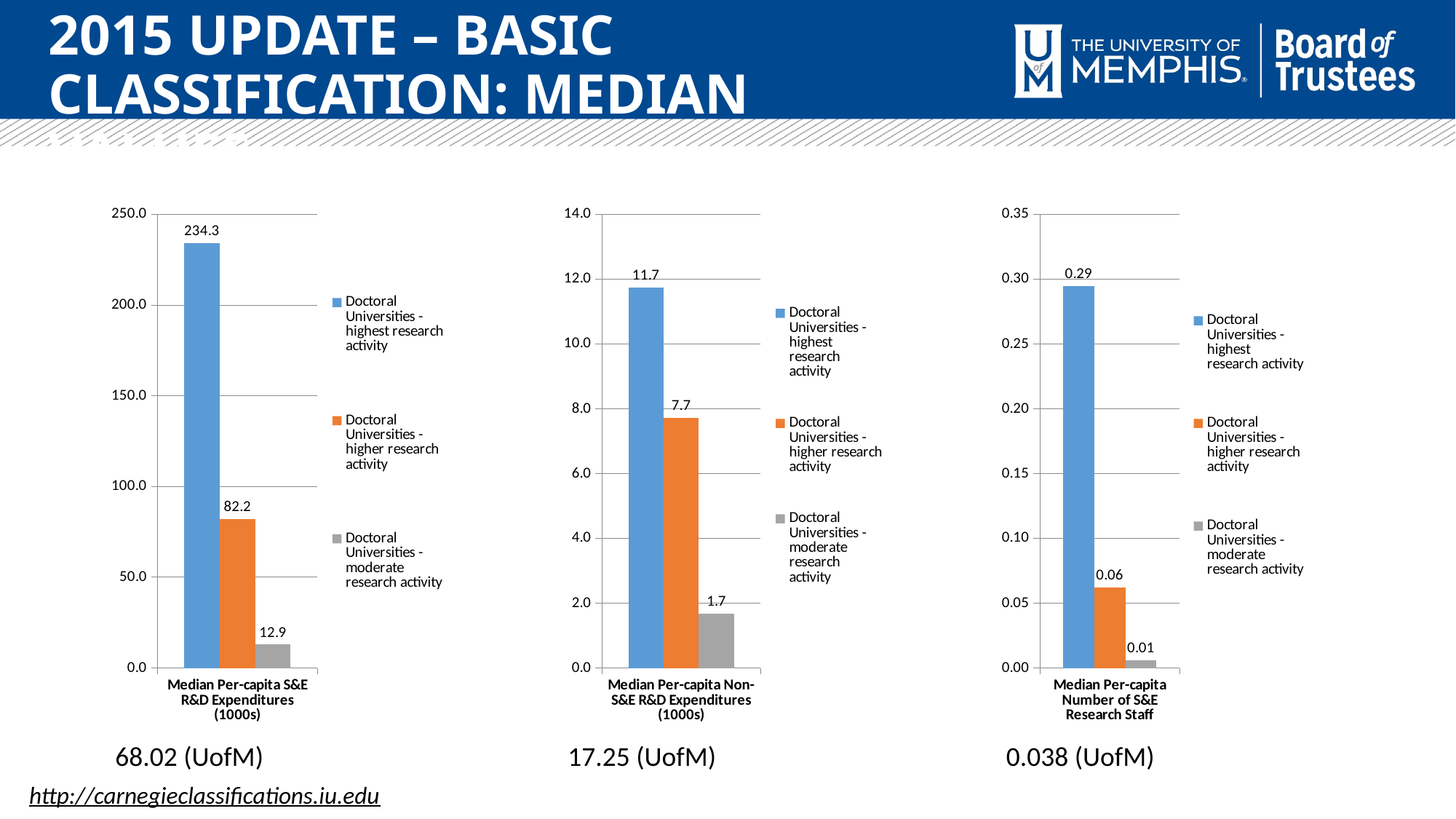
How many series does the legend of the middle chart (Median Per-capita Non-S&E R&D Expenditures) list? 3 In the left chart (Median Per-capita S&E R&D Expenditures), what is the difference between the highest research activity value and the higher research activity value? 152.1 In the right chart (Median Per-capita Number of S&E Research Staff), which is larger: the value for higher research activity or the value for moderate research activity? higher research activity In the left chart (Median Per-capita S&E R&D Expenditures), is the value for Doctoral Universities - higher research activity greater or less than 100.0? less In the right chart (Median Per-capita Number of S&E Research Staff), which series has the lowest value? Doctoral Universities - moderate research activity What kind of chart is the right chart (Median Per-capita Number of S&E Research Staff)? bar chart In the left chart (Median Per-capita S&E R&D Expenditures), what is the value for Doctoral Universities - highest research activity? 234.3 In the left chart (Median Per-capita S&E R&D Expenditures), what is the value for Doctoral Universities - moderate research activity? 12.9 In the middle chart (Median Per-capita Non-S&E R&D Expenditures), what is the difference between the higher research activity value and the moderate research activity value? 6.0 In the right chart (Median Per-capita Number of S&E Research Staff), what is the value for Doctoral Universities - highest research activity? 0.29 In the middle chart (Median Per-capita Non-S&E R&D Expenditures), which series has the highest value? Doctoral Universities - highest research activity In the middle chart (Median Per-capita Non-S&E R&D Expenditures), what is the value for Doctoral Universities - higher research activity? 7.7